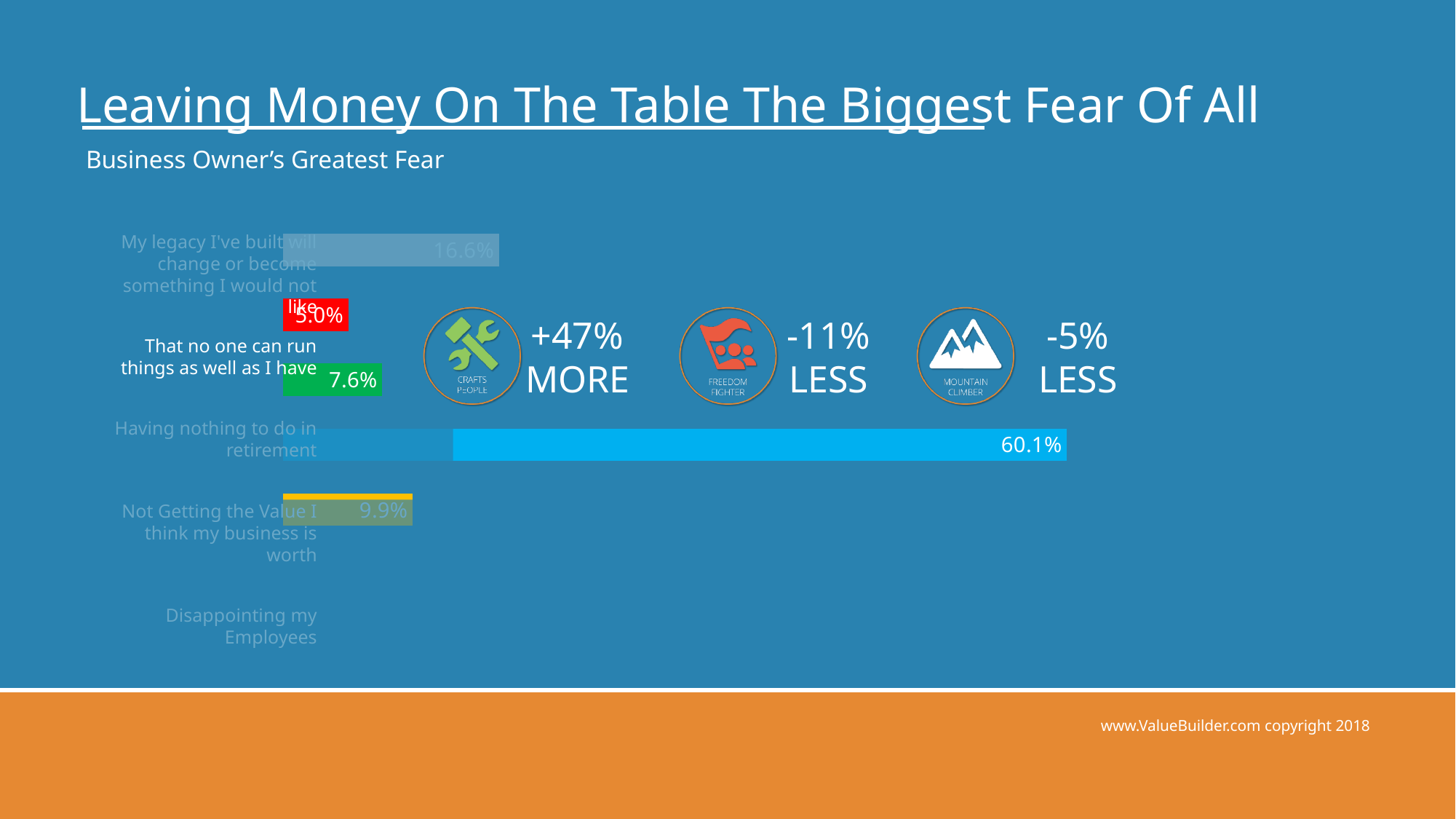
How many fear categories are listed on the chart's axis? 5 What value is labelled on the bar next to 'My legacy I've built will change or become something I would not like'? 16.6% What type of chart is shown on the slide? bar chart What value is labelled on the green bar? 7.6% What is the difference between the 16.6% bar and the 9.9% bar? 6.7 percentage points Which is larger, the 16.6% bar or the 9.9% bar? 16.6% What is the smallest value labelled on the chart? 5.0% What is the title of the chart on the slide? Business Owner's Greatest Fear What percentage is shown next to the 'Crafts People' icon overlaid on the chart? +47% MORE What is the largest value labelled on the chart? 60.1% What is the difference between the 60.1% bar and the 9.9% bar? 50.2 percentage points